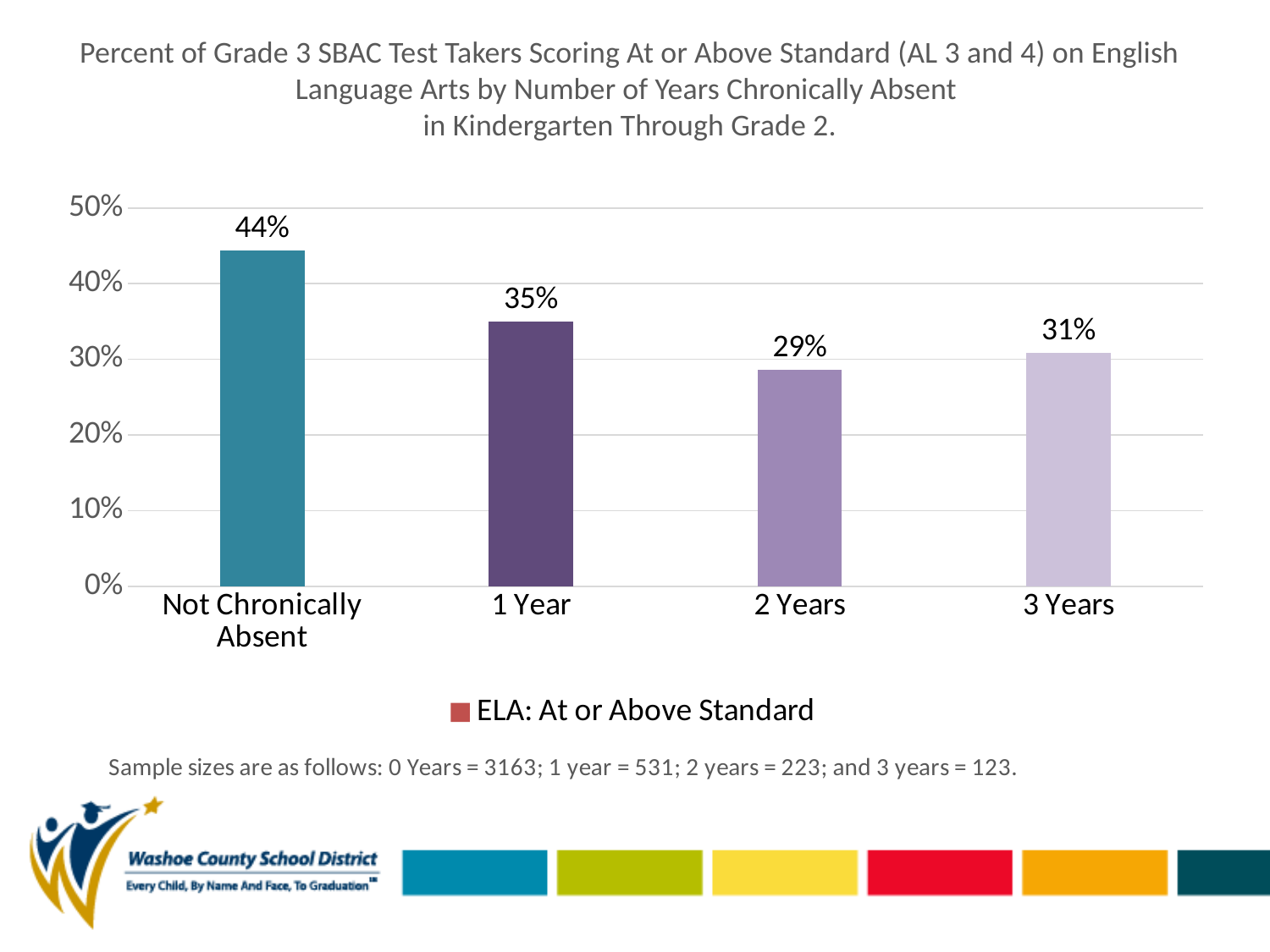
What is the value shown for the 1 Year category? 35% How many series does the legend list? 1 Which category has the highest percent scoring at or above standard? Not Chronically Absent Which category has the lowest percent scoring at or above standard? 2 Years How many categories are shown on the x axis? 4 What is the difference in percentage points between the Not Chronically Absent and 3 Years categories? 13 What percent of Grade 3 SBAC test takers who were Not Chronically Absent scored at or above standard on ELA? 44% What is the value shown for the 2 Years category? 29% What is the value shown for the 3 Years category? 31% Which has a higher value, 1 Year or 2 Years? 1 Year What kind of chart is shown on the slide? Bar chart What is the legend entry for the series shown? ELA: At or Above Standard